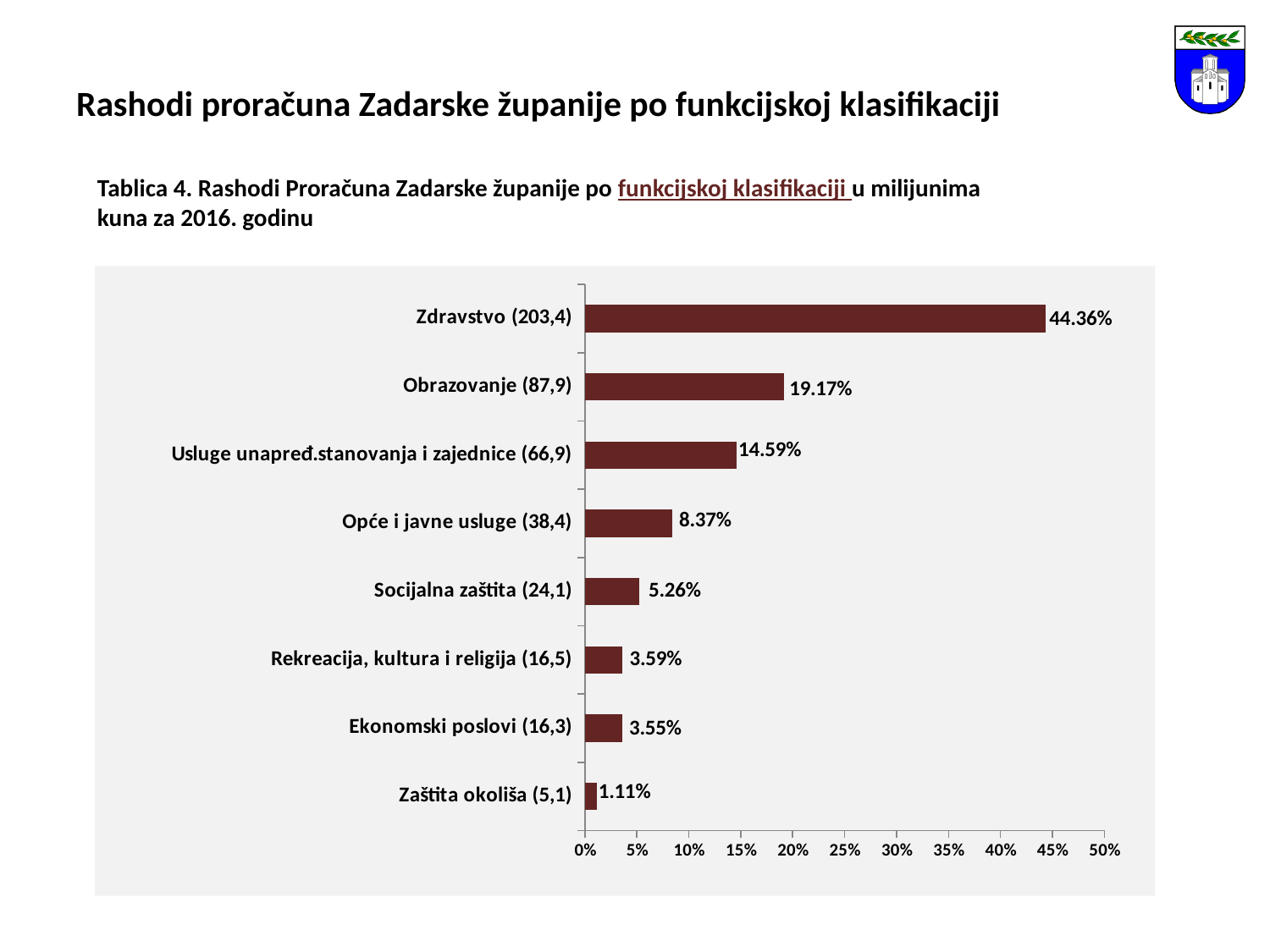
Which category has the lowest percentage? Zaštita okoliša (5,1) What percentage is shown for Obrazovanje (87,9)? 19.17% Is the value for Usluge unapređ.stanovanja i zajednice (66,9) greater or less than 10%? greater What percentage is shown for Socijalna zaštita (24,1)? 5.26% How many categories are shown in the chart? 8 Which category has the highest percentage? Zdravstvo (203,4) Which is larger, the value for Opće i javne usluge (38,4) or the value for Socijalna zaštita (24,1)? Opće i javne usluge (38,4) What percentage is shown for Ekonomski poslovi (16,3)? 3.55% What is the maximum value shown on the percentage axis? 50% What kind of chart is shown on the slide? bar chart What is the difference in percentage points between Zdravstvo (203,4) and Obrazovanje (87,9)? 25.19 What percentage is shown for Zdravstvo (203,4)? 44.36%